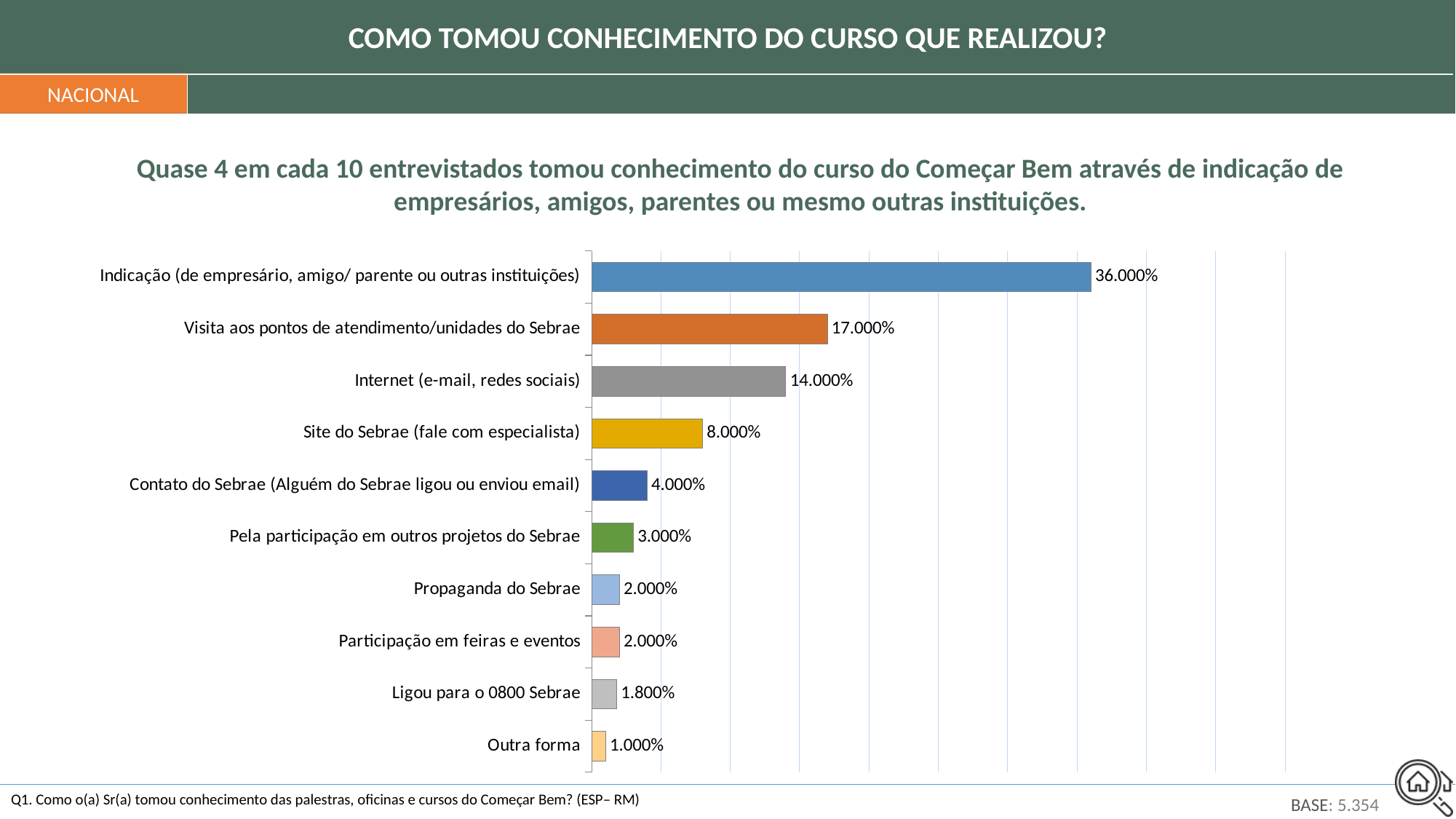
What is the value for "Internet (e-mail, redes sociais)"? 14.000% Which category has the highest value? Indicação (de empresário, amigo/ parente ou outras instituições) What is the difference between the values for "Site do Sebrae (fale com especialista)" and "Contato do Sebrae (Alguém do Sebrae ligou ou enviou email)"? 4.000% Which category has the lowest value? Outra forma What is the value for "Ligou para o 0800 Sebrae"? 1.800% How many categories are shown in the chart? 10 What is the value for "Indicação (de empresário, amigo/ parente ou outras instituições)"? 36.000% What kind of chart is shown on the slide? bar chart Which is larger, the value for "Internet (e-mail, redes sociais)" or the value for "Site do Sebrae (fale com especialista)"? Internet (e-mail, redes sociais) What is the difference between the values for "Indicação (de empresário, amigo/ parente ou outras instituições)" and "Visita aos pontos de atendimento/unidades do Sebrae"? 19.000% What is the base (number of respondents) shown on the slide? 5.354 What is the value for "Visita aos pontos de atendimento/unidades do Sebrae"? 17.000%